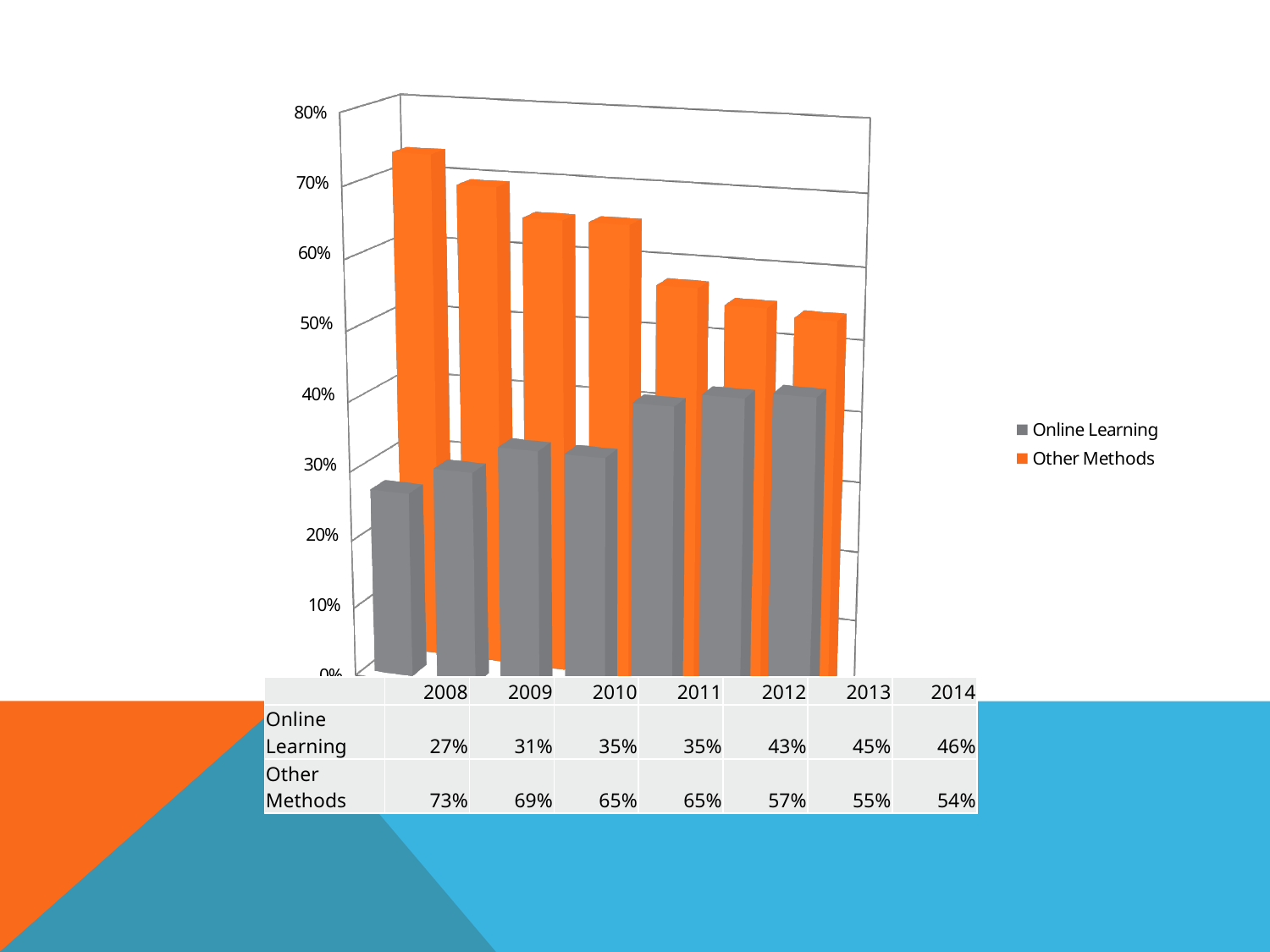
What is the value for Online Learning in 2014? 46% What is the value for Online Learning in 2008? 27% What is the difference between Other Methods and Online Learning in 2010? 30% In which year is Other Methods highest? 2008 How many series does the legend list? 2 How many years are shown on the x axis? 7 What colour are the Other Methods bars? Orange What kind of chart is this? Bar chart What is the value for Other Methods in 2012? 57% Do the Online Learning values rise or fall from 2008 to 2014? Rise In which year is Online Learning lowest? 2008 Which is larger in 2013, Online Learning or Other Methods? Other Methods